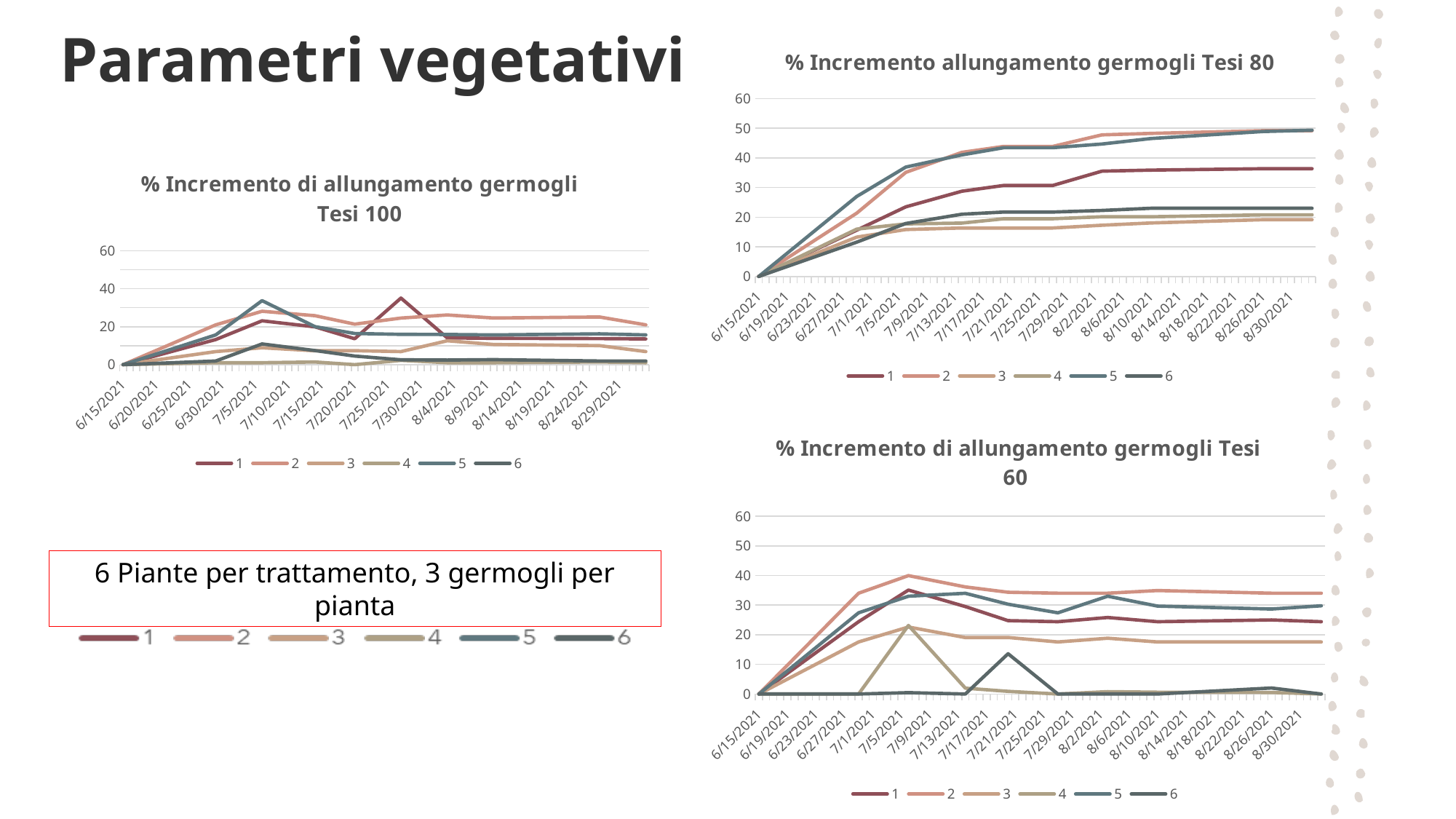
How many series does the legend of '% Incremento di allungamento germogli Tesi 60' list? 6 In '% Incremento di allungamento germogli Tesi 60', which series has the highest value on 8/30/2021? 2 In '% Incremento allungamento germogli Tesi 80', what is the value for series 1 on 6/15/2021? 0 What kind of chart is '% Incremento allungamento germogli Tesi 80'? line chart In '% Incremento allungamento germogli Tesi 80', which is larger on 8/30/2021: series 1 or series 6? series 1 In '% Incremento allungamento germogli Tesi 80', which series has the highest value on 7/1/2021? 5 In '% Incremento allungamento germogli Tesi 80', is the value for series 1 on 8/30/2021 greater or less than 30? greater In '% Incremento allungamento germogli Tesi 80', do the values for series 2 rise or fall from 6/15/2021 to 8/30/2021? rise In '% Incremento di allungamento germogli Tesi 100', is the value for series 5 on 7/5/2021 greater or less than 20? greater How many charts are shown on the slide? 3 In '% Incremento allungamento germogli Tesi 80', is the value for series 6 on 8/30/2021 greater or less than 30? less